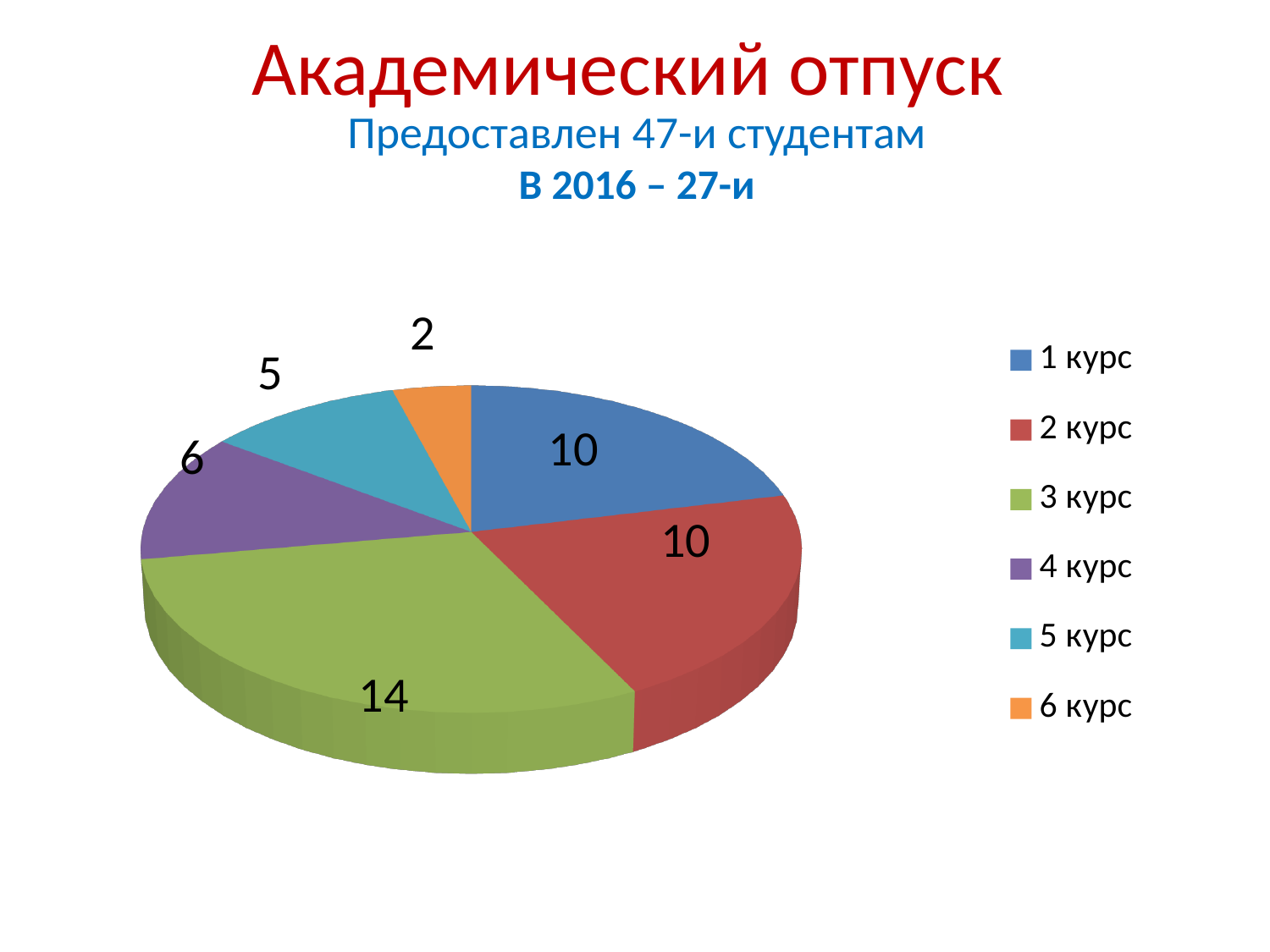
What is the value for 6 курс? 2 What is the value for 3 курс? 14 What type of chart is shown on the slide? pie chart What is the total of all slices in the pie chart? 47 How many slices does the pie chart have? 6 Which course has the largest slice? 3 курс What colour is the slice for 3 курс? green Which course has the smallest slice? 6 курс Which is larger, the value for 4 курс or 5 курс? 4 курс How many entries does the legend list? 6 What is the value for 4 курс? 6 What is the difference between the values for 3 курс and 4 курс? 8